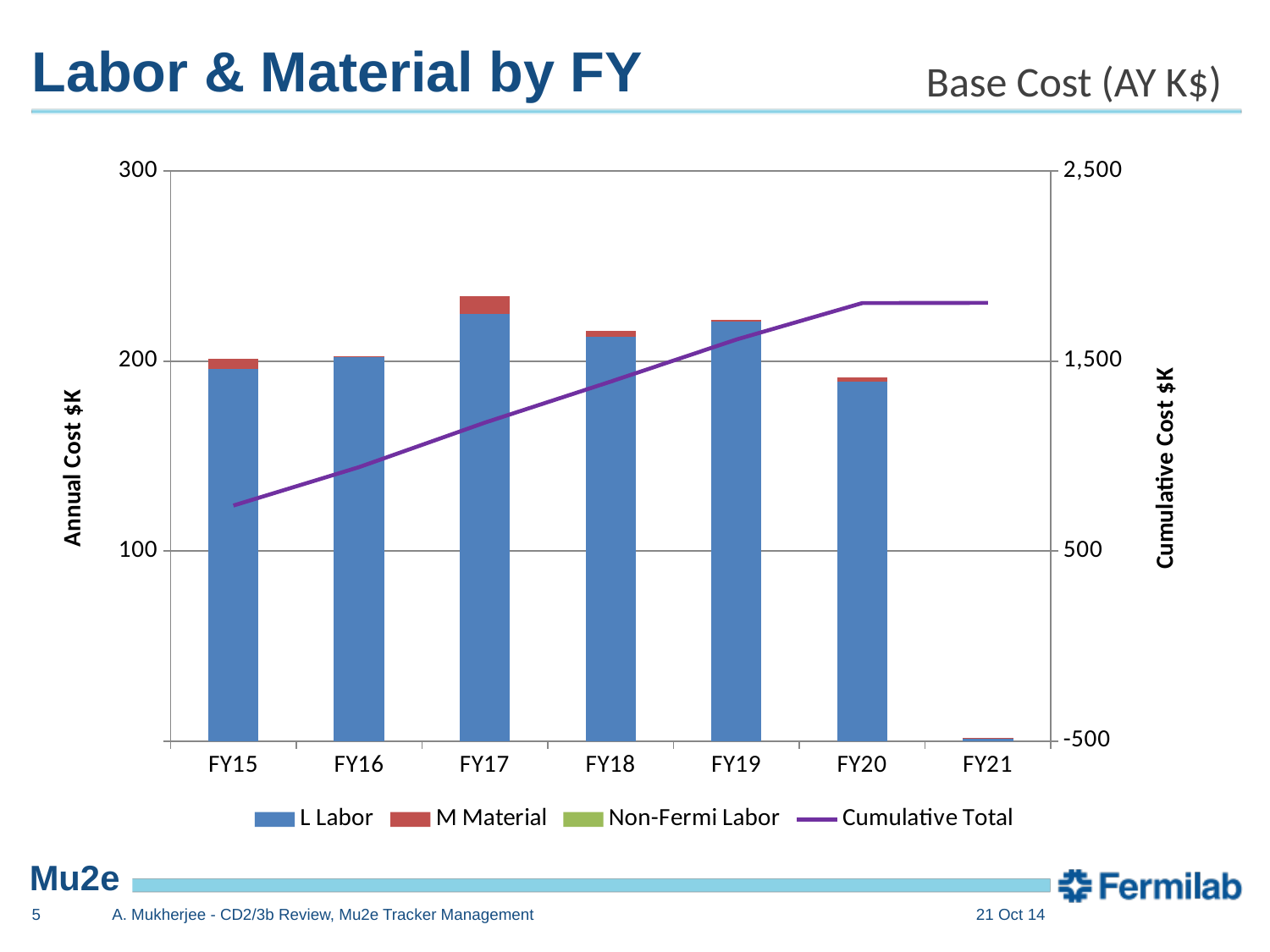
Which stacked bar is taller, FY16 or FY20? FY16 How many series does the legend list? 4 Which fiscal year has the tallest stacked bar? FY17 Does the Cumulative Total line rise or fall from FY15 to FY20? rise Is the Cumulative Total at FY15 greater or less than 1,500 on the Cumulative Cost $K axis? less Is the stacked bar for FY20 greater or less than 200 on the Annual Cost $K axis? less Is the stacked bar for FY17 greater or less than 200 on the Annual Cost $K axis? greater What kind of chart is shown on the slide? A stacked bar chart with a line overlay What is the title of the left vertical axis? Annual Cost $K How many fiscal years are shown on the x axis? 7 Which fiscal year has the smallest stacked bar? FY21